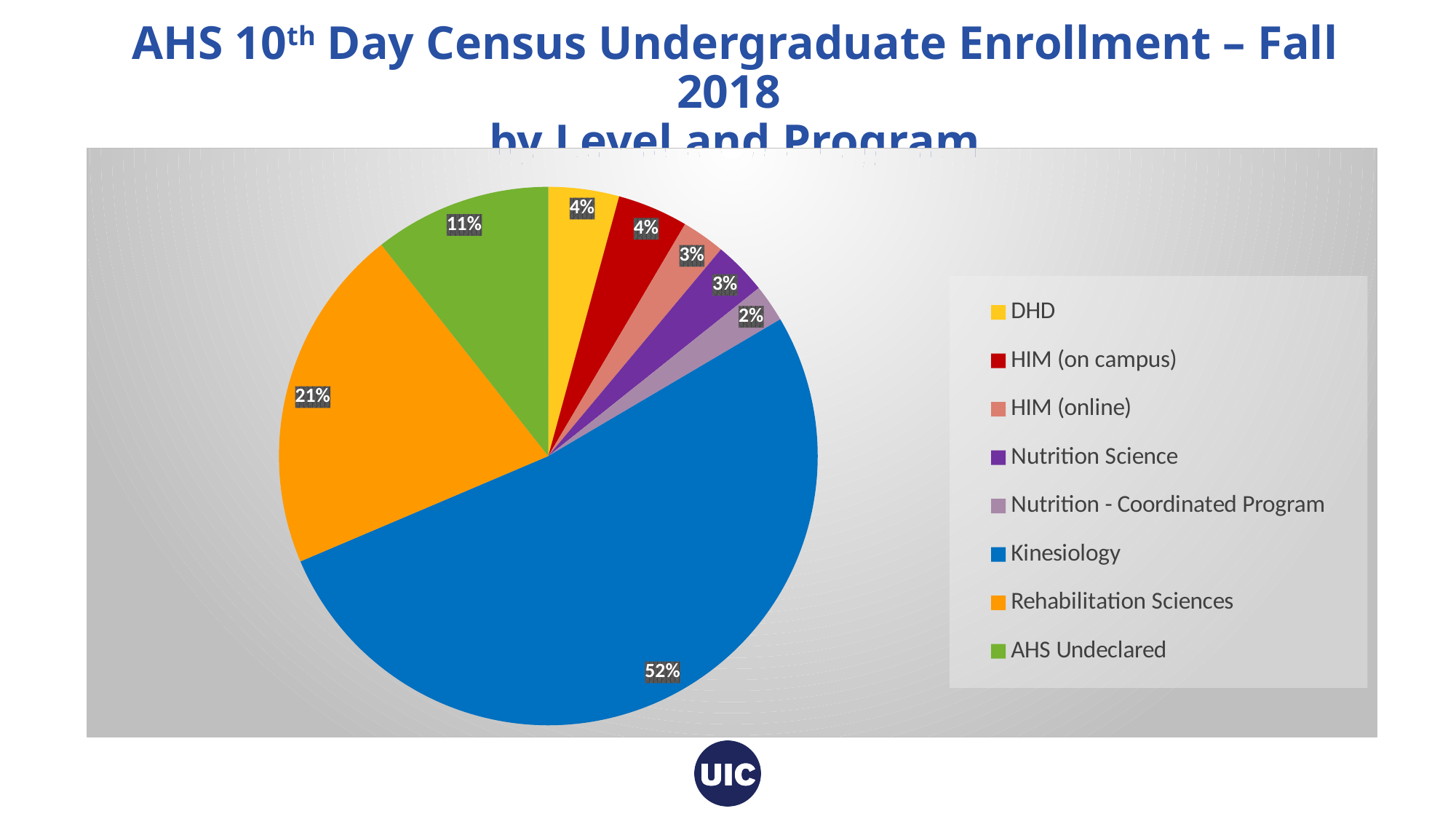
What percentage is shown for Nutrition - Coordinated Program? 2% What percentage is shown for AHS Undeclared? 11% What type of chart is shown on the slide? pie chart What share of the pie does Kinesiology represent? 52% Which program has the largest slice of the pie? Kinesiology What percentage is shown for DHD? 4% What percentage is shown for Rehabilitation Sciences? 21% What colour is the Kinesiology slice? blue How many programs are listed in the legend? 8 What is the difference in percentage points between Kinesiology and Rehabilitation Sciences? 31 Which is larger, the share for Rehabilitation Sciences or the share for AHS Undeclared? Rehabilitation Sciences Which program has the smallest slice of the pie? Nutrition - Coordinated Program